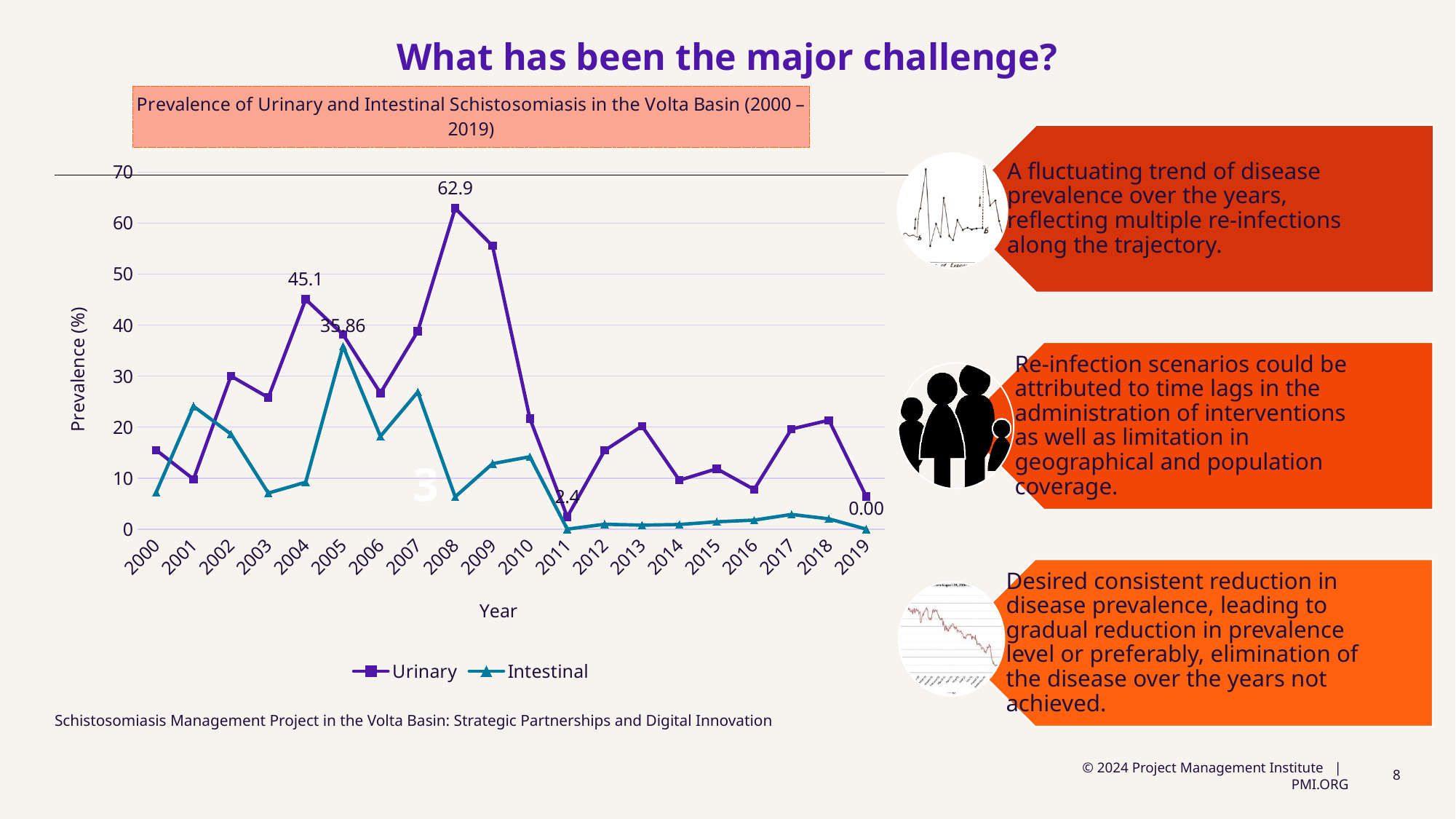
Is the Urinary value for 2009 greater or less than 50? greater In which year does the Urinary series reach its highest value? 2008 What is the difference between the Urinary values in 2008 and 2004? 17.8 In which year does the Urinary series reach its lowest value? 2011 How many series does the legend list? 2 How many years are plotted along the x axis? 20 What is the Urinary prevalence value in 2008? 62.9 What is the label on the y axis? Prevalence (%) What is the Urinary prevalence value in 2004? 45.1 What is the Intestinal prevalence value in 2005? 35.86 What is the Intestinal prevalence value in 2019? 0.00 What kind of chart is shown on the slide? line chart